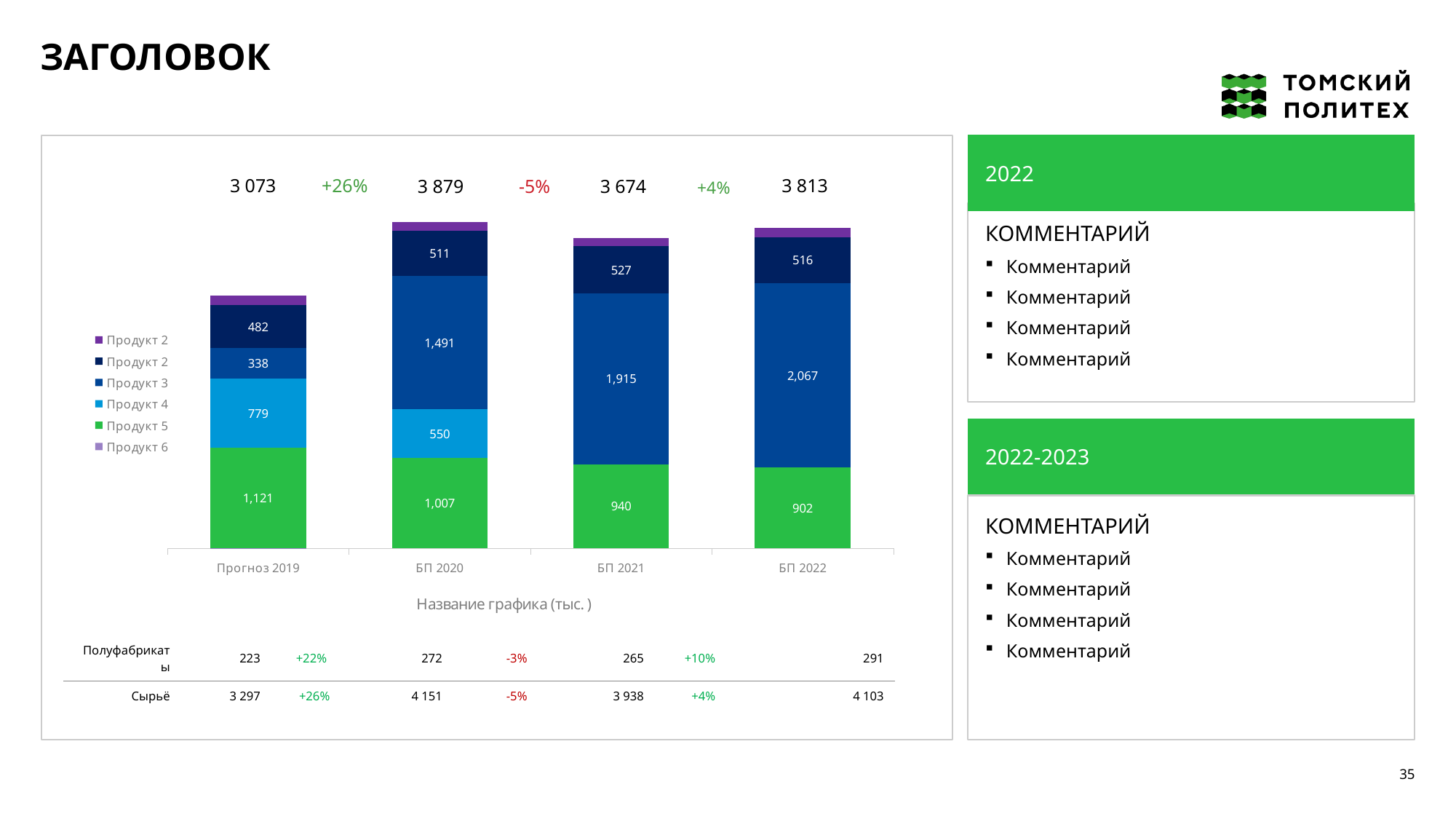
What kind of chart is shown on the slide? Stacked bar chart How many categories are shown along the x axis of the chart? 4 Does the Продукт 5 value rise or fall from Прогноз 2019 to БП 2022? Fall What is the value of Продукт 4 for БП 2020? 550 What is the difference between the Продукт 5 value for Прогноз 2019 and for БП 2022? 219 Which category has the highest total? БП 2020 What is the value of Продукт 5 for Прогноз 2019? 1,121 What is the value of Продукт 3 for БП 2022? 2,067 Which category has the lowest total? Прогноз 2019 How many series does the chart legend list? 6 What is the total shown above the stacked bar for БП 2020? 3 879 Which is larger, the Продукт 3 value for БП 2021 or for БП 2022? БП 2022